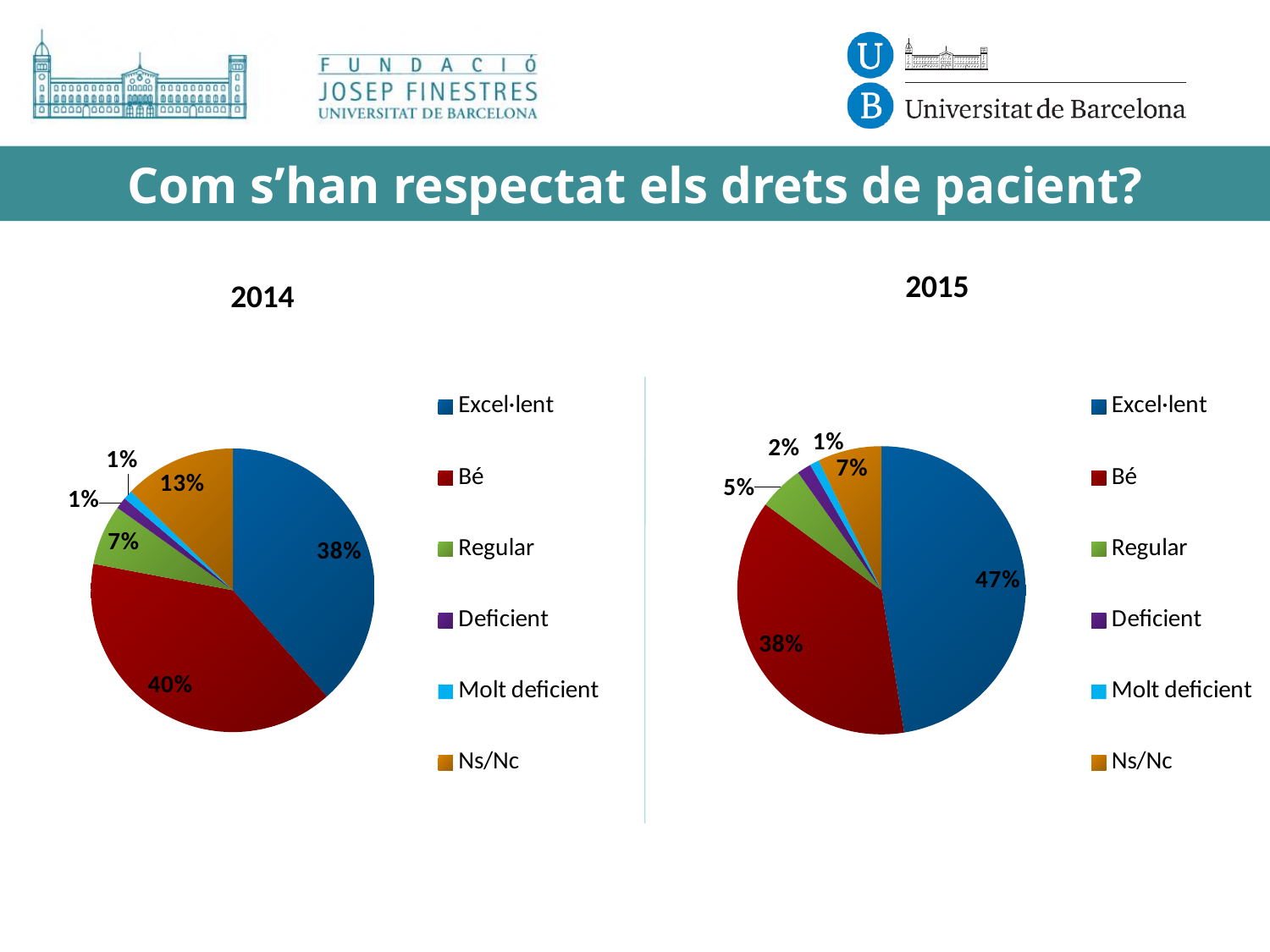
In the 2015 pie chart, which is larger: the share for Bé or the share for Regular? Bé How many categories does the legend of the 2014 pie chart list? 6 What type of chart is used for the 2015 data? Pie chart In the 2014 pie chart, what percentage is shown for Bé? 40% In the 2015 pie chart, what percentage is shown for Regular? 5% In the 2015 pie chart, which category has the smallest share? Molt deficient In the 2014 pie chart, which category has the largest share? Bé In the 2015 pie chart, which category has the largest share? Excel·lent What is the difference between the Excel·lent share in 2015 and the Excel·lent share in 2014? 9 percentage points In the 2015 pie chart, what percentage is shown for Excel·lent? 47% In the 2014 pie chart, what percentage is shown for Ns/Nc? 13% In the 2015 pie chart, what colour represents Ns/Nc? Orange